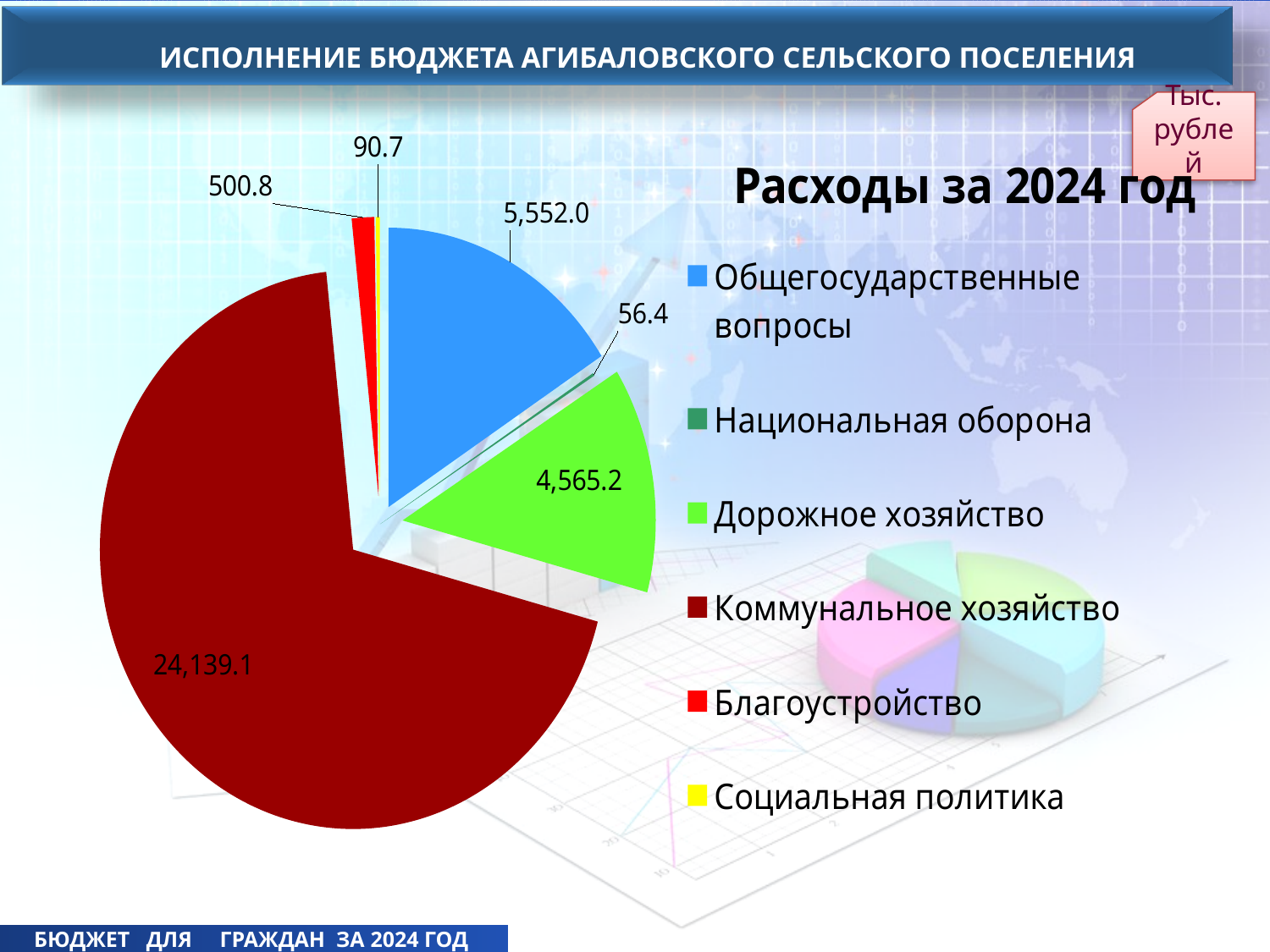
Which is larger, the value for Благоустройство or the value for Социальная политика? Благоустройство What is the value for Коммунальное хозяйство? 24,139.1 Which category has the smallest value? Национальная оборона Which category has the largest slice of the pie? Коммунальное хозяйство What is the title of the chart? Расходы за 2024 год What is the value for Национальная оборона? 56.4 What is the value for Дорожное хозяйство? 4,565.2 What is the value for Общегосударственные вопросы? 5,552.0 How many categories does the legend of the pie chart list? 6 What is the difference between the values for Общегосударственные вопросы and Дорожное хозяйство? 986.8 What type of chart is shown on the slide? Pie chart What is the value for Социальная политика? 90.7